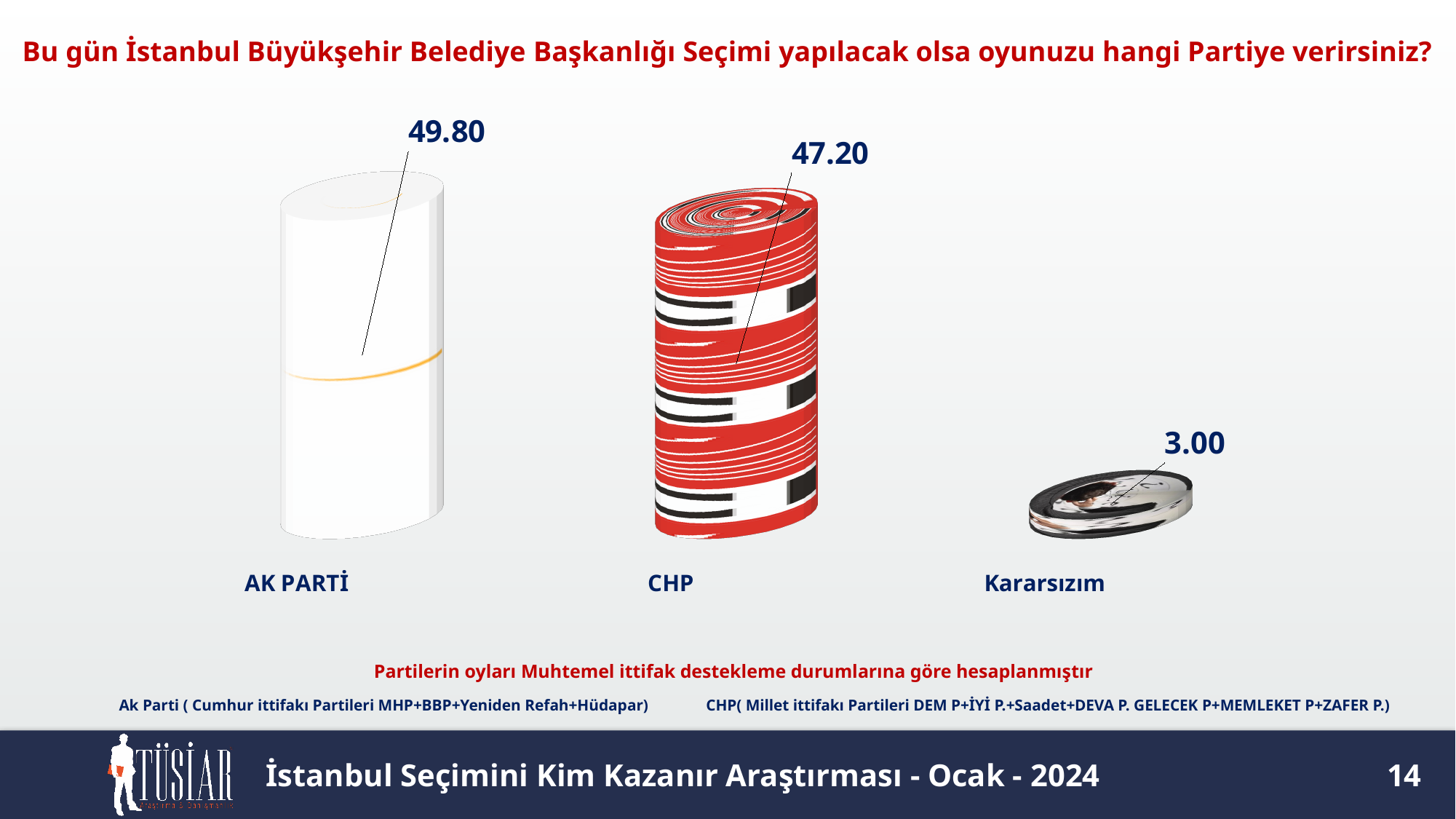
What is the title of the chart on the slide? Bu gün İstanbul Büyükşehir Belediye Başkanlığı Seçimi yapılacak olsa oyunuzu hangi Partiye verirsiniz? Which category has the lowest value? Kararsızım What kind of chart is shown on the slide? Bar chart How many categories are shown in the chart? 3 What is the difference between the values for AK PARTİ and CHP? 2.60 What is the value shown for CHP? 47.20 What is the value shown for Kararsızım? 3.00 Which is larger, the value for AK PARTİ or the value for CHP? AK PARTİ What is the total of the three values shown in the chart? 100.00 Which category has the highest value? AK PARTİ What is the difference between the values for CHP and Kararsızım? 44.20 What is the value shown for AK PARTİ? 49.80